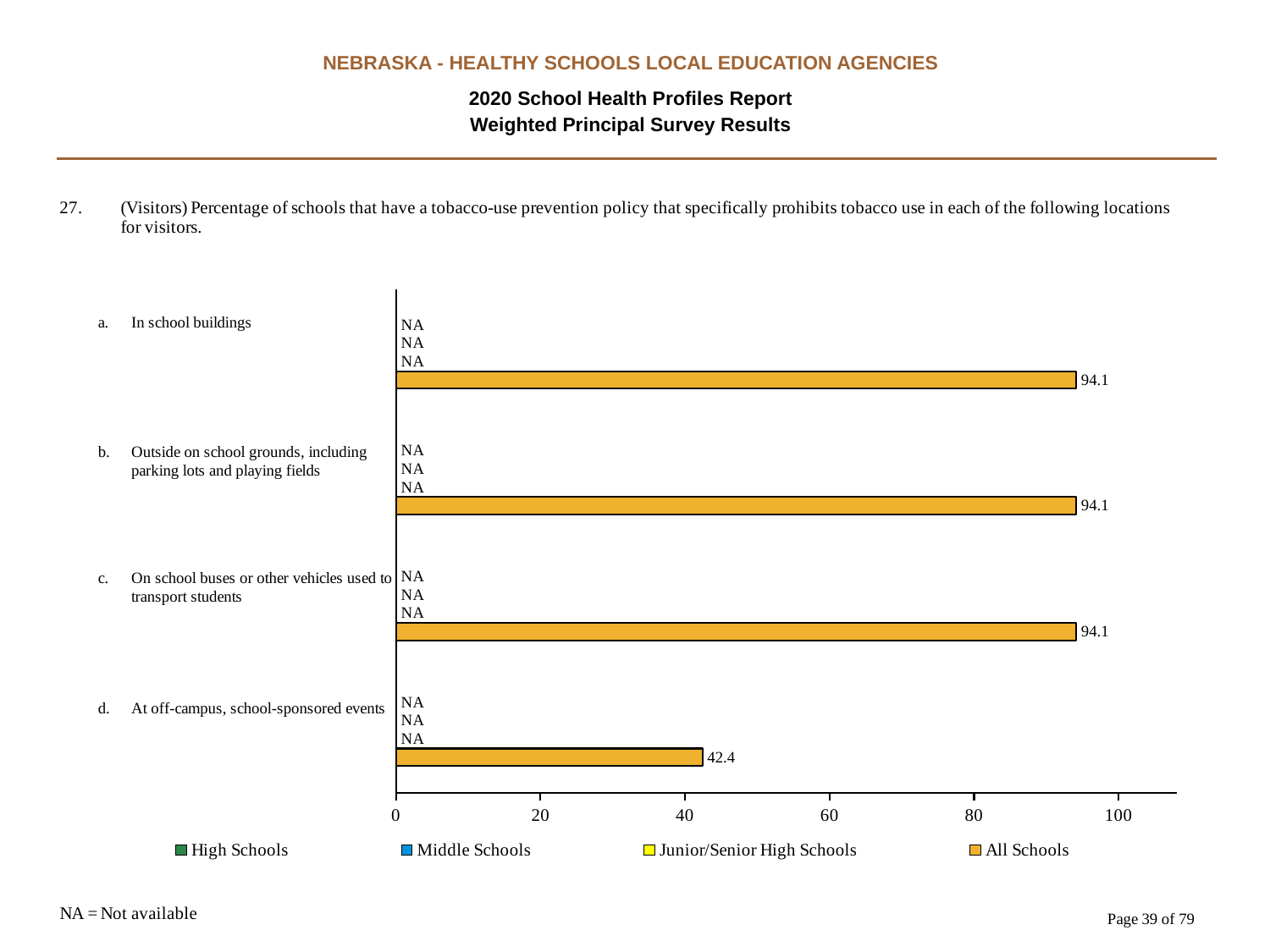
Which is larger: the All Schools value for 'Outside on school grounds, including parking lots and playing fields' or for 'At off-campus, school-sponsored events'? Outside on school grounds, including parking lots and playing fields What is the difference between the All Schools values for 'In school buildings' and 'At off-campus, school-sponsored events'? 51.7 Is the All Schools value for 'At off-campus, school-sponsored events' greater or less than 60? less How many series does the legend list? 4 Which location has the lowest All Schools value? At off-campus, school-sponsored events What does NA stand for according to the slide? Not available What kind of chart is shown on the slide? bar chart How many locations (categories) are shown in the chart? 4 What is the All Schools value for 'In school buildings'? 94.1 What is the All Schools value for 'At off-campus, school-sponsored events'? 42.4 What value is shown for High Schools for 'In school buildings'? NA What is the All Schools value for 'On school buses or other vehicles used to transport students'? 94.1